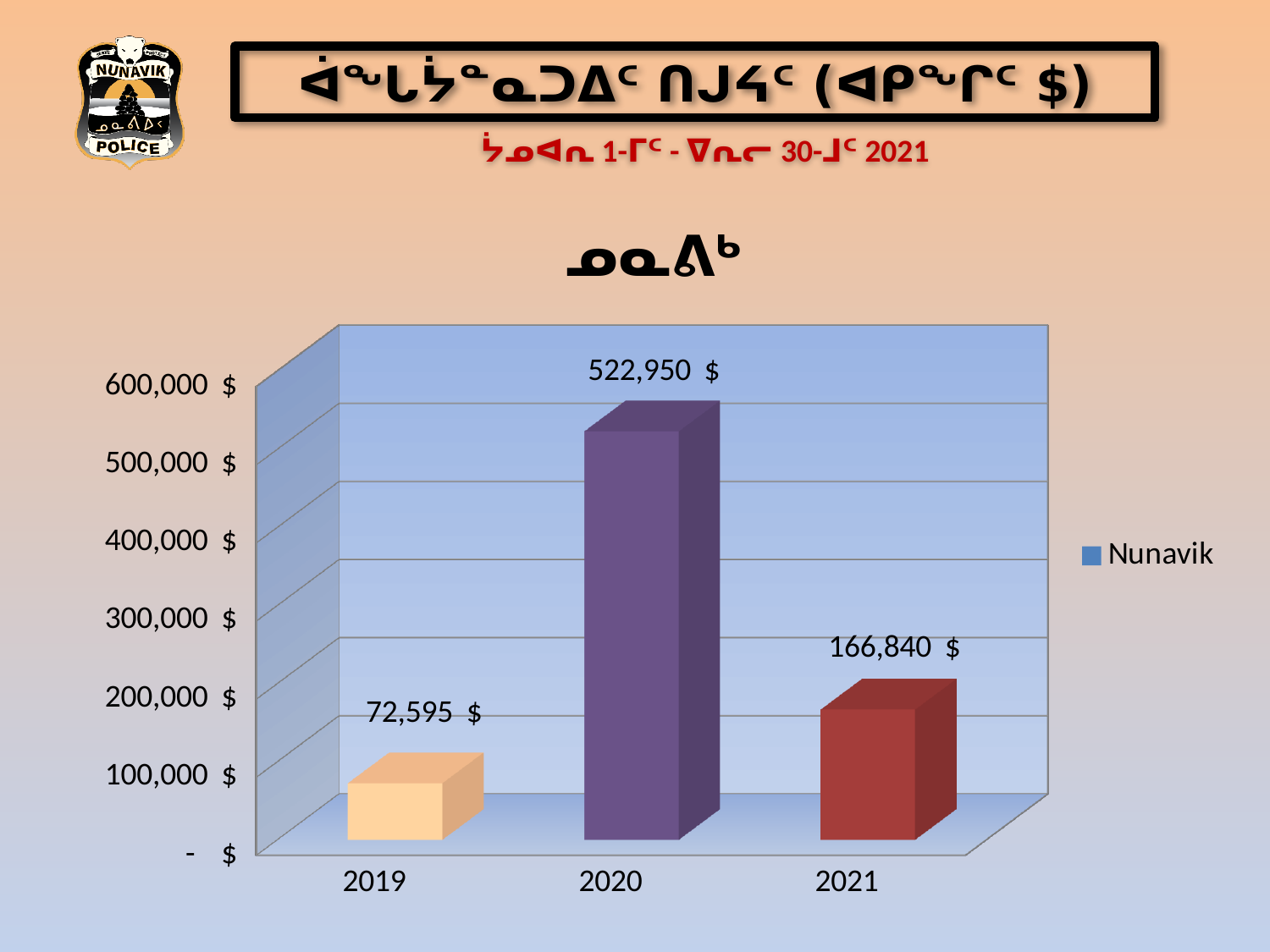
What is the value for 2021? 166,840 $ What series name does the legend list? Nunavik Which year has the highest value? 2020 What is the value for 2020? 522,950 $ What is the difference between the values for 2021 and 2019? 94,245 $ How many years are shown on the x axis? 3 What is the difference between the values for 2020 and 2021? 356,110 $ What kind of chart is shown on the slide? bar chart What is the value for 2019? 72,595 $ Which is larger, the value for 2019 or the value for 2021? 2021 Is the value for 2020 greater or less than 500,000 $? greater Which year has the lowest value? 2019